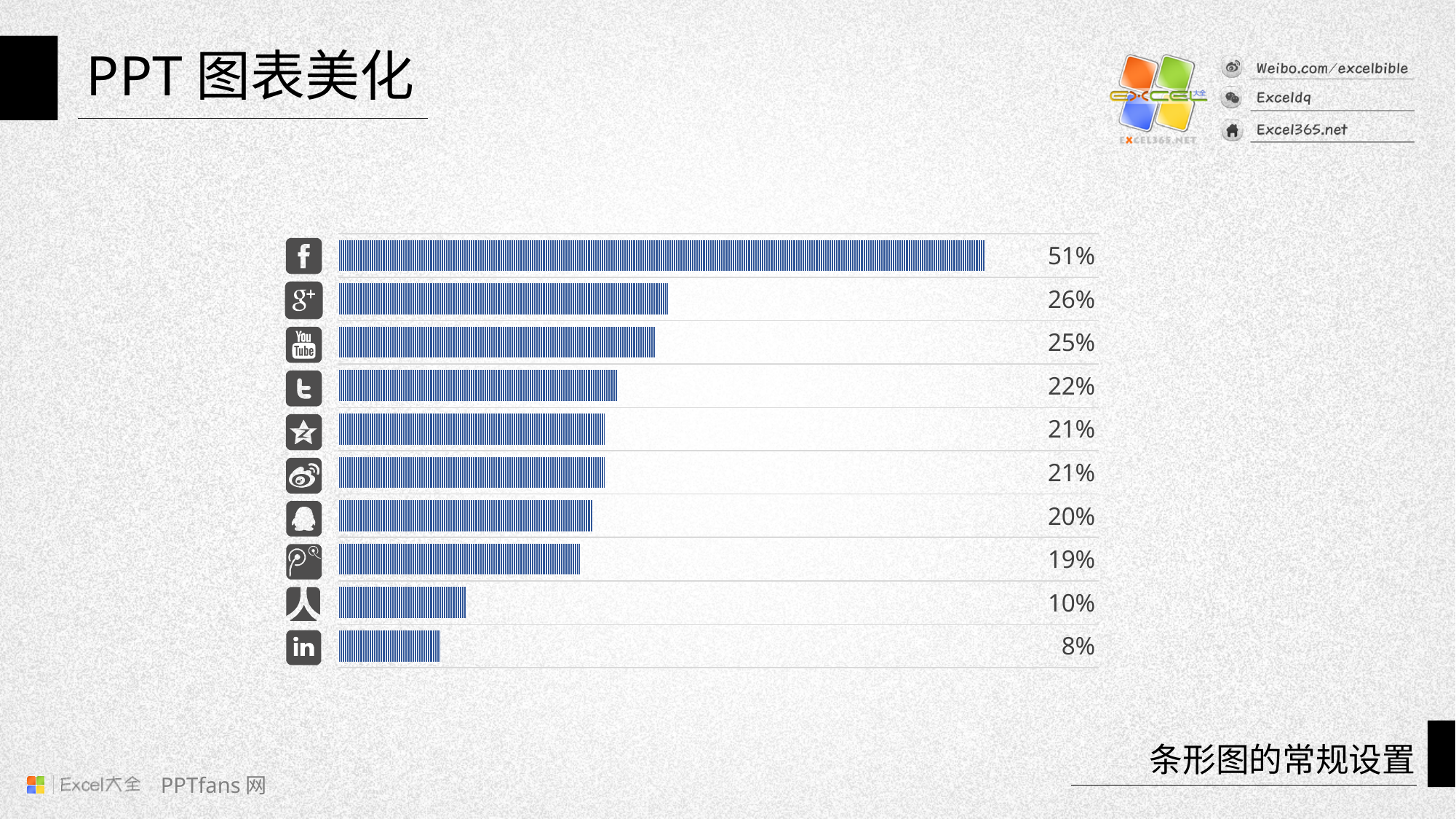
What is the value for the YouTube bar? 25% Which is larger, the Google+ bar or the YouTube bar? Google+ (26%) Which category has the highest value? Facebook (top bar, 51%) What colour are the bars in the chart? blue What kind of chart is shown on the slide? bar chart How many bars (categories) does the chart show? 10 What is the value for the Facebook bar (top bar)? 51% What is the difference between the Facebook bar (51%) and the Google+ bar (26%)? 25% Which category has the lowest value? LinkedIn (bottom bar, 8%) What is the value for the LinkedIn bar (bottom bar)? 8% Do the bar values increase or decrease from the top bar to the bottom bar? decrease What is the value for the Twitter bar? 22%